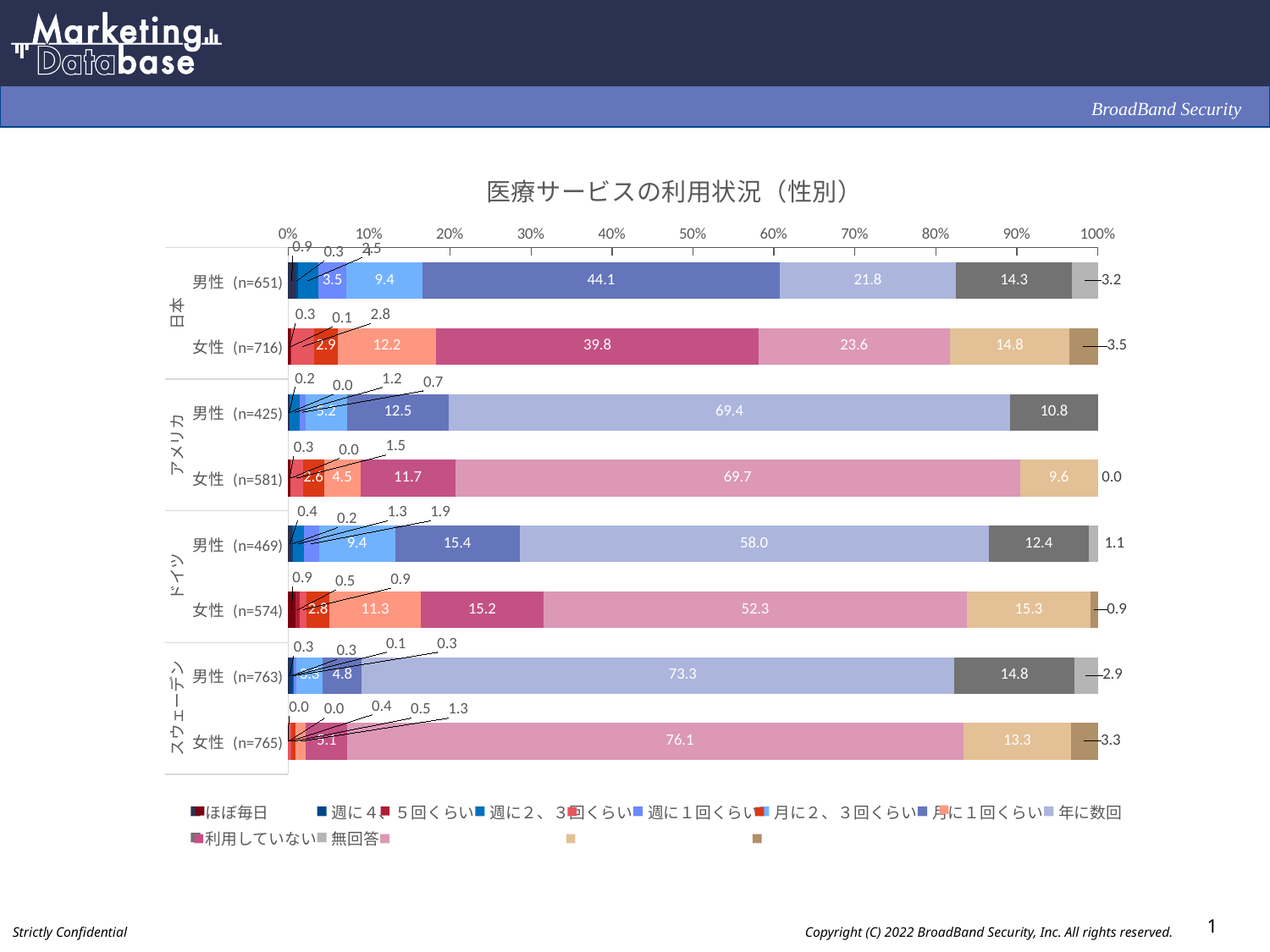
How many series does the legend list? 9 Which bar has the lowest 利用していない value? アメリカ 女性 (n=581) What is the value of the largest segment (年に数回) in the スウェーデン 女性 (n=765) bar? 76.1 What is the difference between the 年に数回 values for アメリカ 男性 (n=425) and ドイツ 男性 (n=469)? 11.4 What is the title of the chart? 医療サービスの利用状況（性別） Which is larger, the 利用していない value for ドイツ 女性 (n=574) or for ドイツ 男性 (n=469)? ドイツ 女性 (n=574) What is the value of the 利用していない segment for 日本 男性 (n=651)? 14.3 Which bar has the highest 年に数回 value? スウェーデン 女性 (n=765) What is the value of the 月に1回くらい segment for 日本 女性 (n=716)? 39.8 What is the sample size (n) shown for アメリカ 男性? 425 How many category bars (country × gender groups) are plotted in the chart? 8 What type of chart is shown on the slide? stacked bar chart